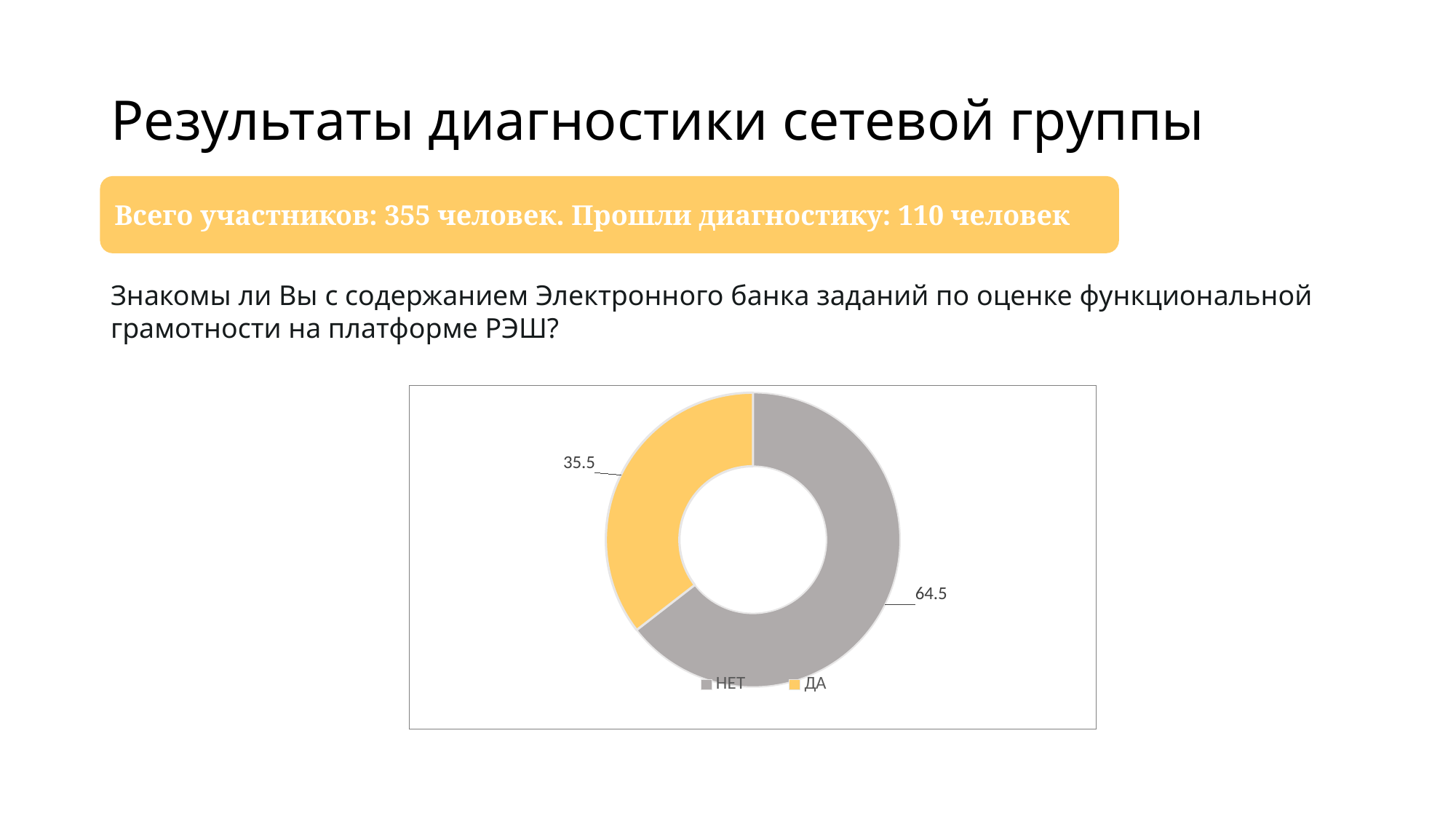
How many entries does the legend list? 2 How many slices does the chart have? 2 Which slice is the smallest? ДА Which is larger, the value for ДА or the value for НЕТ? НЕТ What kind of chart is shown on the slide? Doughnut (pie) chart What is the difference between the НЕТ and ДА values? 29 What colour is the НЕТ slice? Grey What is the total of the two slice values? 100 What value is shown for the ДА slice? 35.5 What colour is the ДА slice? Yellow What value is shown for the НЕТ slice? 64.5 Which slice is the largest? НЕТ